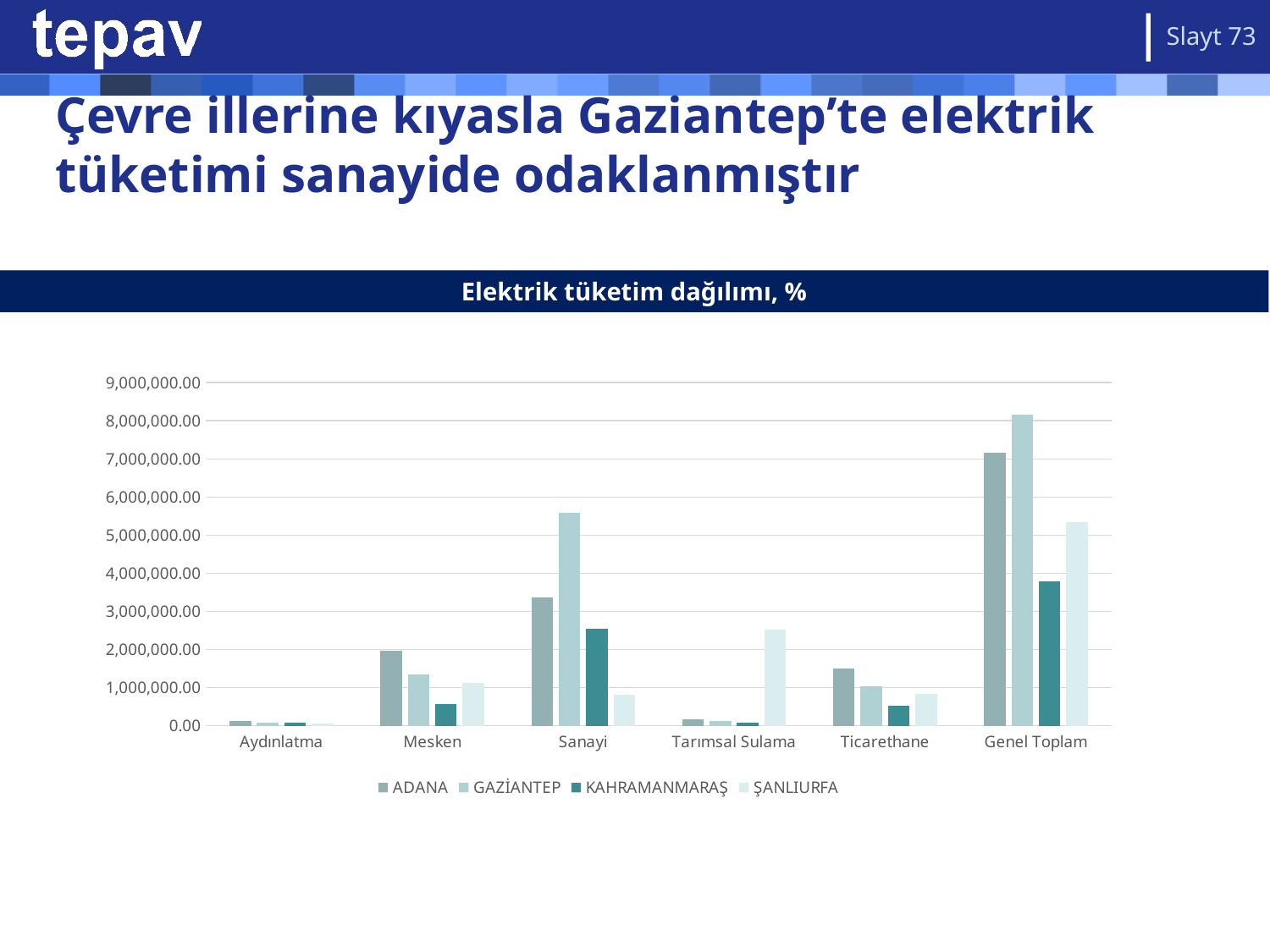
Which series has the highest value in the Sanayi category? GAZİANTEP Which series has the highest value in the Tarımsal Sulama category? ŞANLIURFA How many series does the legend list? 4 What kind of chart is shown on the slide? bar chart Is the value for ŞANLIURFA in Tarımsal Sulama greater or less than 2,000,000.00? greater How many categories are shown on the x axis? 6 Which series has the highest value in the Genel Toplam category? GAZİANTEP What is the title of the chart? Elektrik tüketim dağılımı, % In the Mesken category, which is larger: ADANA or GAZİANTEP? ADANA Is the value for ADANA in Genel Toplam greater or less than 6,000,000.00? greater Which series has the lowest value in the Mesken category? KAHRAMANMARAŞ Is the value for GAZİANTEP in Sanayi greater or less than 5,000,000.00? greater